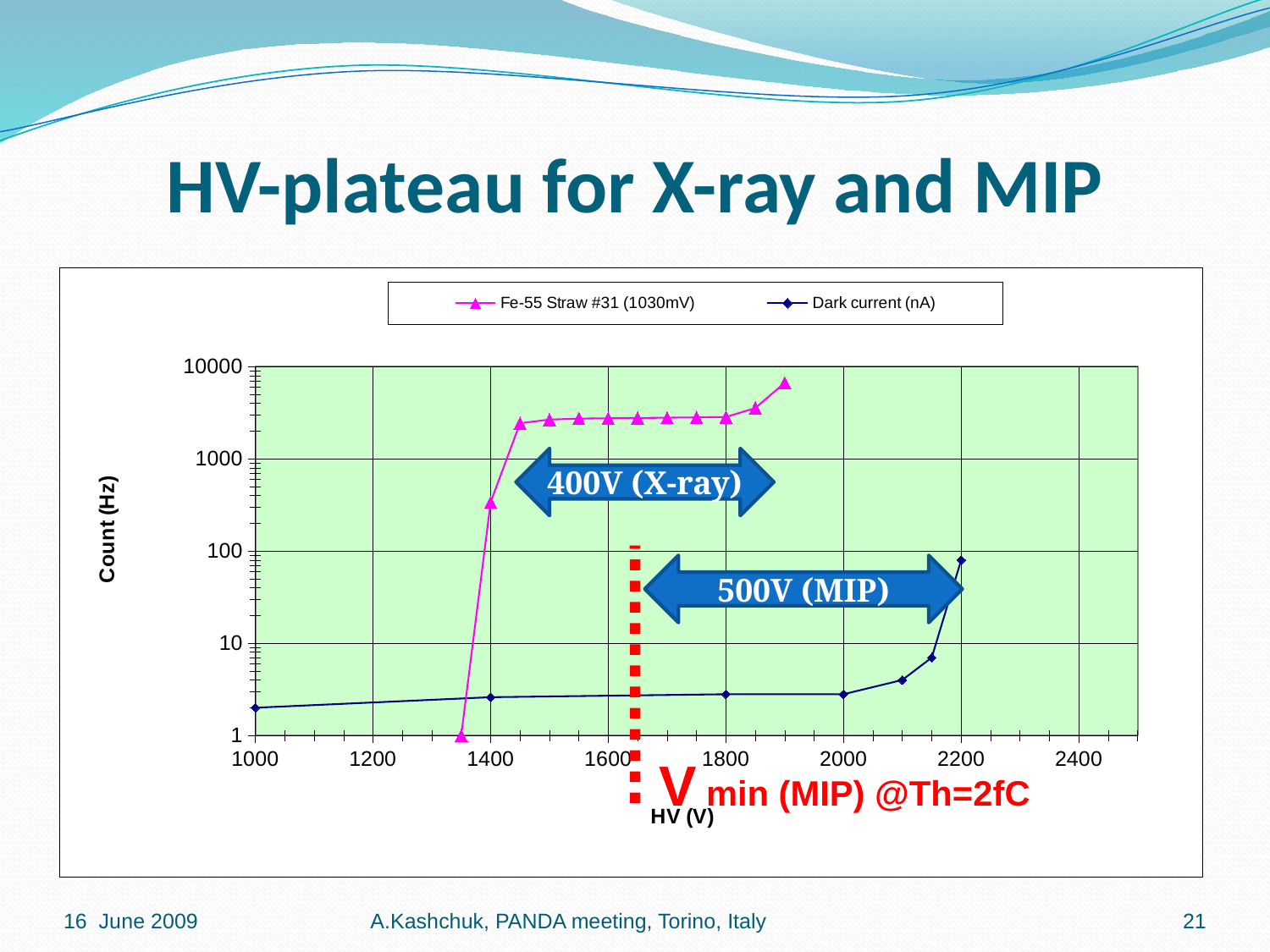
What is the title of the slide's chart? HV-plateau for X-ray and MIP What is the label of the y axis? Count (Hz) Does the Dark current (nA) series rise or fall overall as HV increases? rise How many series does the legend list? 2 Is the value of the Dark current (nA) series at HV 2000 V greater or less than 10? less Is the value of the Dark current (nA) series at HV 2200 V greater or less than 10? greater At HV 1800 V, which series has the higher value: Fe-55 Straw #31 (1030mV) or Dark current (nA)? Fe-55 Straw #31 (1030mV) What kind of chart is shown on the slide? line chart Is the value of the Fe-55 Straw #31 (1030mV) series at HV 1400 V greater or less than 100? greater At which HV value does the Fe-55 Straw #31 (1030mV) series reach its highest point? 1900 At which HV value does the Dark current (nA) series reach its highest point? 2200